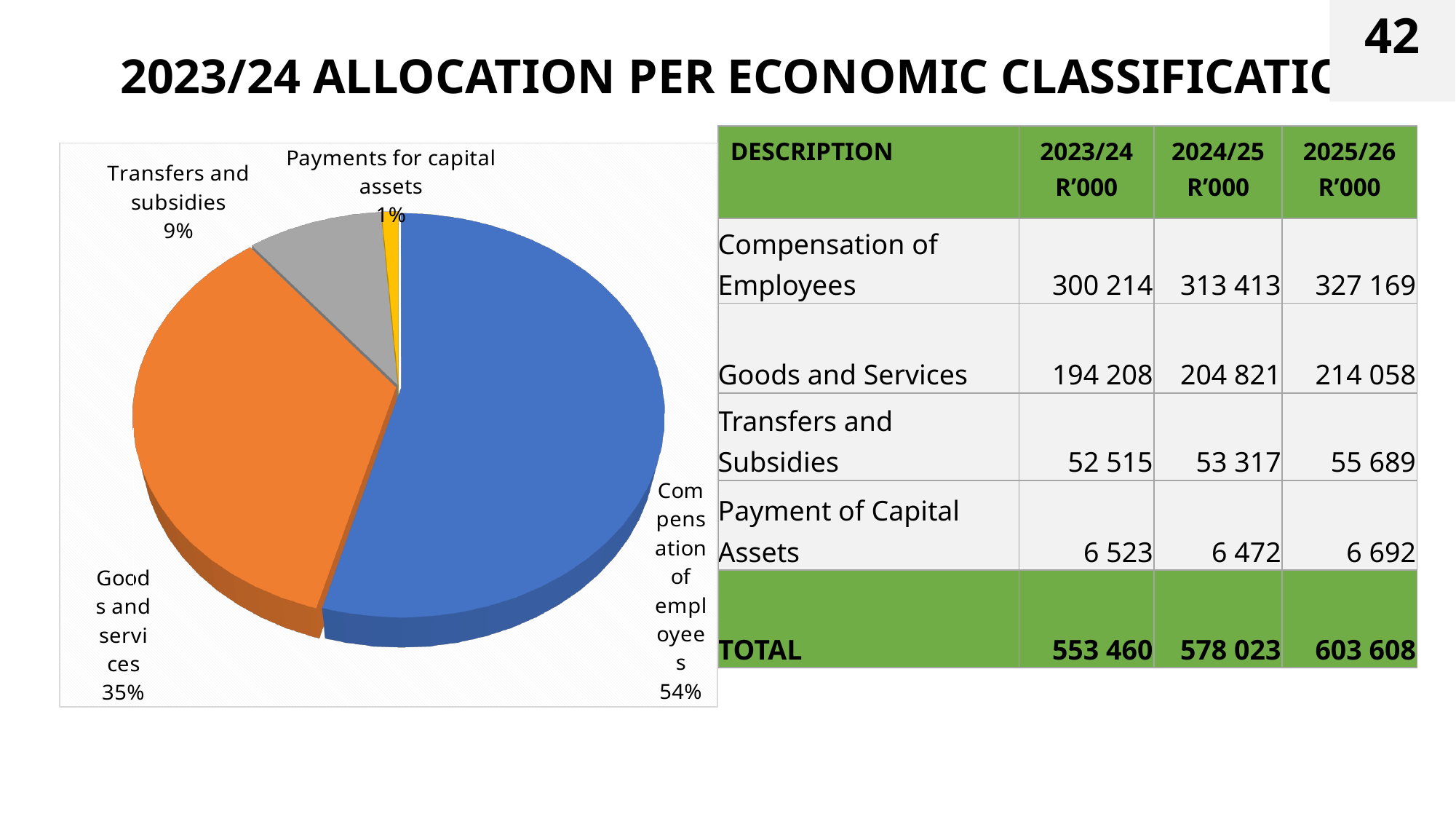
Which category has the smallest slice in the pie chart? Payments for capital assets What share of the pie chart does Payments for capital assets represent? 1% What kind of chart is shown on the slide? Pie chart What colour is the Compensation of employees slice in the pie chart? Blue How many slices does the pie chart have? 4 In the pie chart, which is larger: Goods and services or Transfers and subsidies? Goods and services What share of the pie chart does Transfers and subsidies represent? 9% Which category has the largest slice in the pie chart? Compensation of employees What colour is the Goods and services slice in the pie chart? Orange What share of the pie chart does Compensation of employees represent? 54% What is the difference in percentage points between the Compensation of employees slice and the Goods and services slice? 19 percentage points